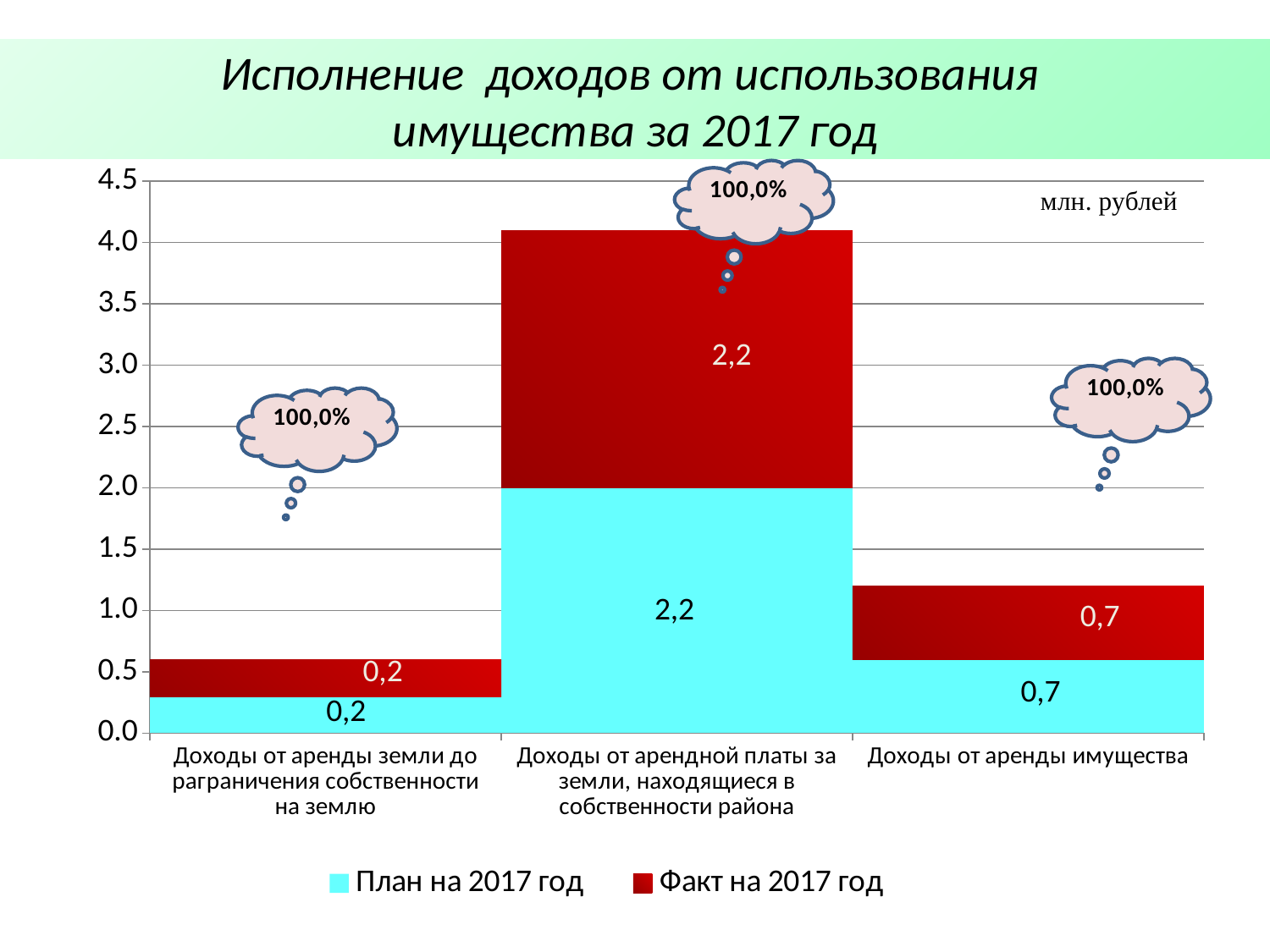
What kind of chart is shown on the slide? bar chart Is the top of the stacked bar for «Доходы от арендной платы за земли, находящиеся в собственности района» greater or less than 3.5? greater How many categories are shown on the x axis? 3 What is the difference between the «План на 2017 год» values for «Доходы от арендной платы за земли, находящиеся в собственности района» and «Доходы от аренды имущества»? 1,5 Which has the larger «План на 2017 год» value: «Доходы от аренды имущества» or «Доходы от аренды земли до разграничения собственности на землю»? Доходы от аренды имущества Which category has the highest «План на 2017 год» value? Доходы от арендной платы за земли, находящиеся в собственности района What is the value of «План на 2017 год» for «Доходы от аренды имущества»? 0,7 Which category has the lowest «Факт на 2017 год» value? Доходы от аренды земли до разграничения собственности на землю How many series does the legend list? 2 What is the value of «План на 2017 год» for «Доходы от аренды земли до разграничения собственности на землю»? 0,2 What unit of measurement is indicated in the top right corner of the chart? млн. рублей What is the value of «Факт на 2017 год» for «Доходы от арендной платы за земли, находящиеся в собственности района»? 2,2